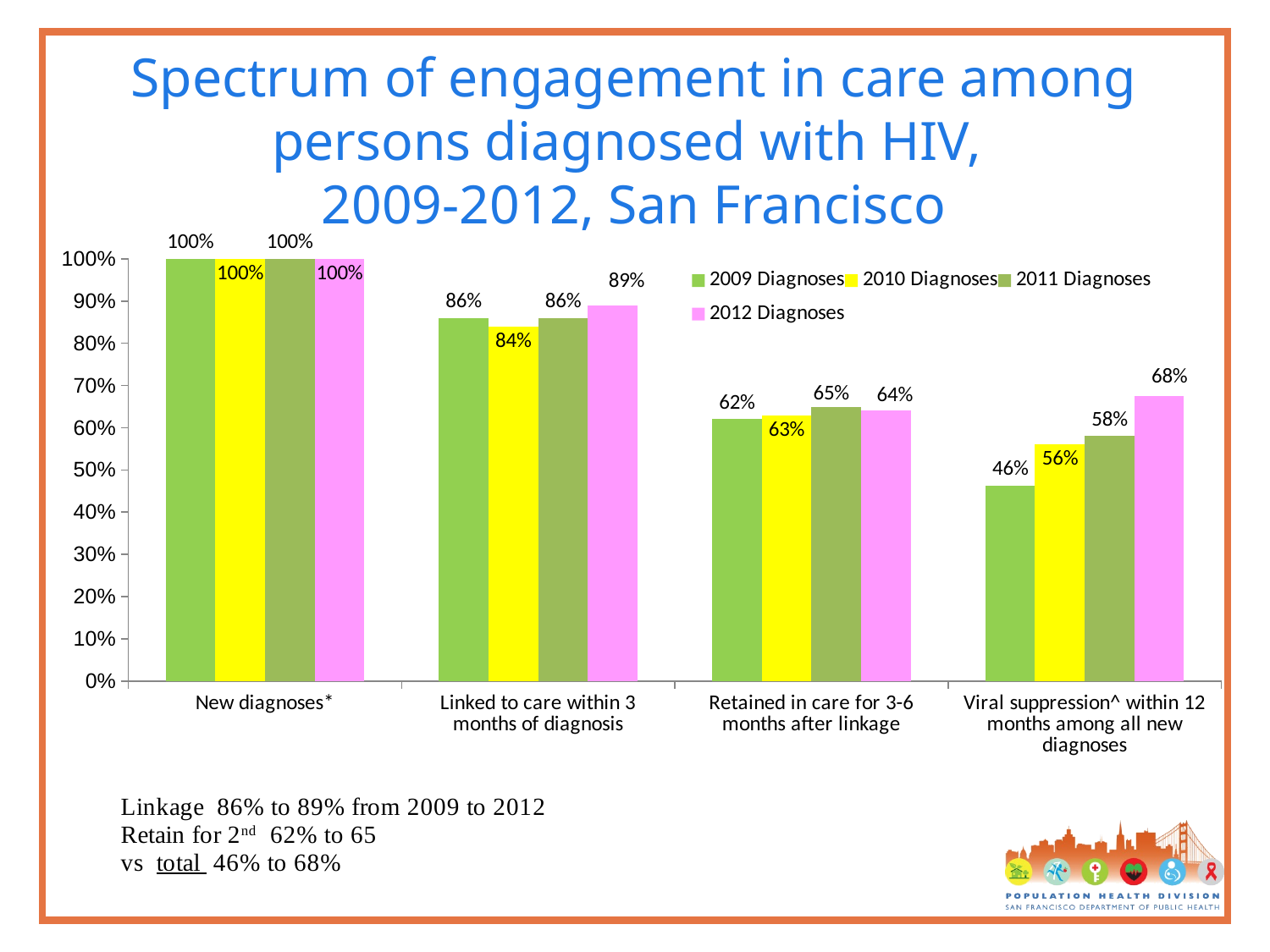
What kind of chart is shown on the slide? Bar chart What is the value for 2009 Diagnoses in the 'Viral suppression^ within 12 months among all new diagnoses' category? 46% Which is larger in the 'Retained in care for 3-6 months after linkage' category: 2011 Diagnoses or 2009 Diagnoses? 2011 Diagnoses Which series has the lowest value in the 'Linked to care within 3 months of diagnosis' category? 2010 Diagnoses Do the 2012 Diagnoses values rise or fall across the categories from left to right? Fall What is the difference between the 2012 Diagnoses and 2009 Diagnoses values in the 'Viral suppression^ within 12 months among all new diagnoses' category? 22% Which series has the highest value in the 'Viral suppression^ within 12 months among all new diagnoses' category? 2012 Diagnoses What is the value for 2012 Diagnoses in the 'Linked to care within 3 months of diagnosis' category? 89% What is the value for 2011 Diagnoses in the 'Linked to care within 3 months of diagnosis' category? 86% What is the value for 2010 Diagnoses in the 'Retained in care for 3-6 months after linkage' category? 63% How many series does the legend list? 4 How many categories are shown on the x axis? 4